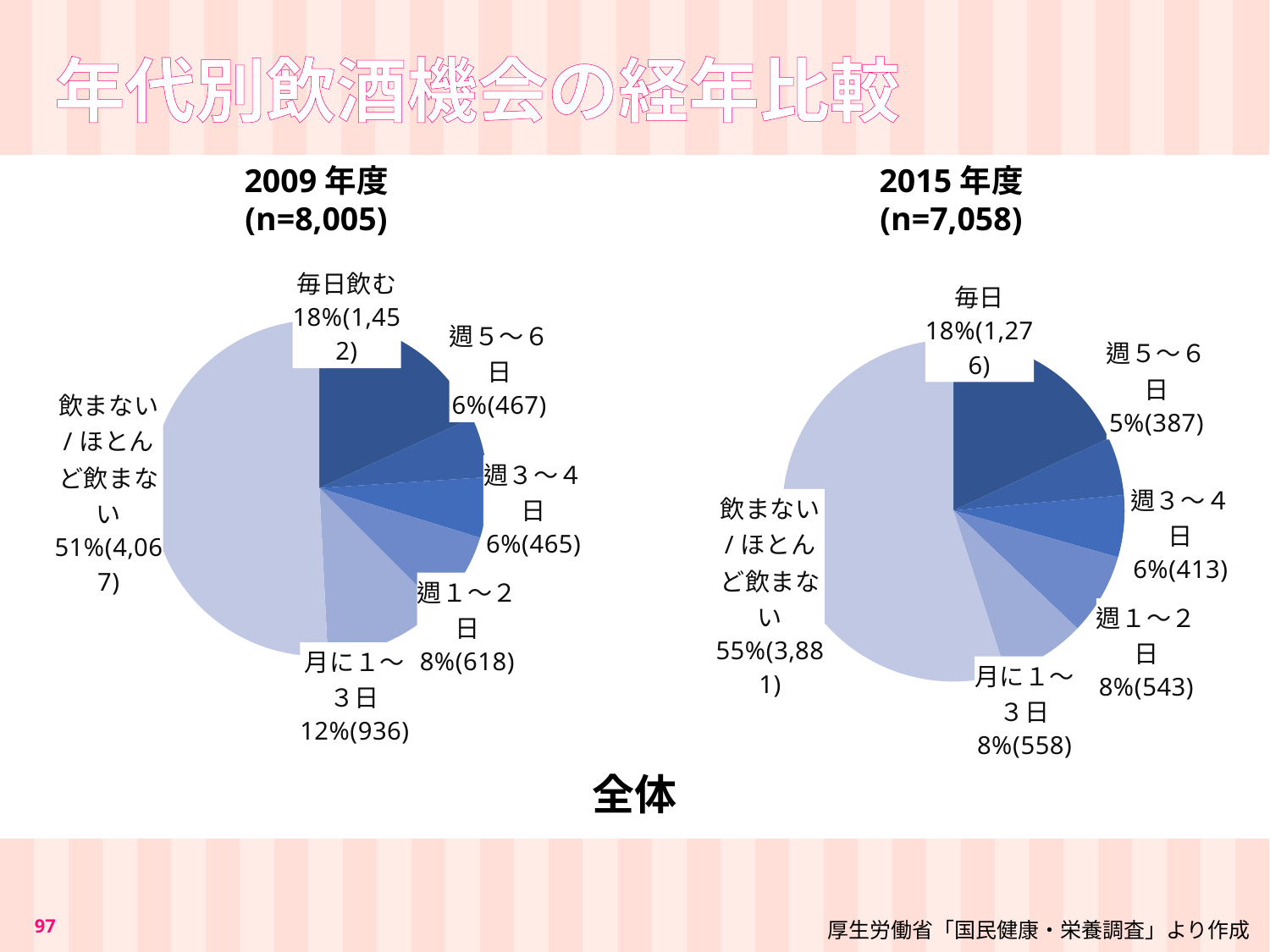
In the 2009年度 pie chart, what share is labelled for 飲まない/ほとんど飲まない? 51% In the 2015年度 pie chart, what share is labelled for 飲まない/ほとんど飲まない? 55% In the 2015年度 pie chart, which category has the smallest slice? 週5〜6日 In the 2009年度 pie chart, what count is shown in parentheses for 毎日飲む? 1,452 What is the difference in percentage points between the 飲まない/ほとんど飲まない share in 2015年度 and in 2009年度? 4 percentage points Which is larger: the 月に1〜3日 share in the 2009年度 chart or in the 2015年度 chart? 2009年度 What is the sample size (n) shown for the 2015年度 chart? 7,058 How many categories does the 2009年度 pie chart show? 6 What type of chart is used on this slide? Pie chart In the 2015年度 pie chart, what share is labelled for 月に1〜3日? 8% In the 2009年度 pie chart, which category has the largest slice? 飲まない/ほとんど飲まない In the 2015年度 pie chart, what count is shown in parentheses for 週5〜6日? 387